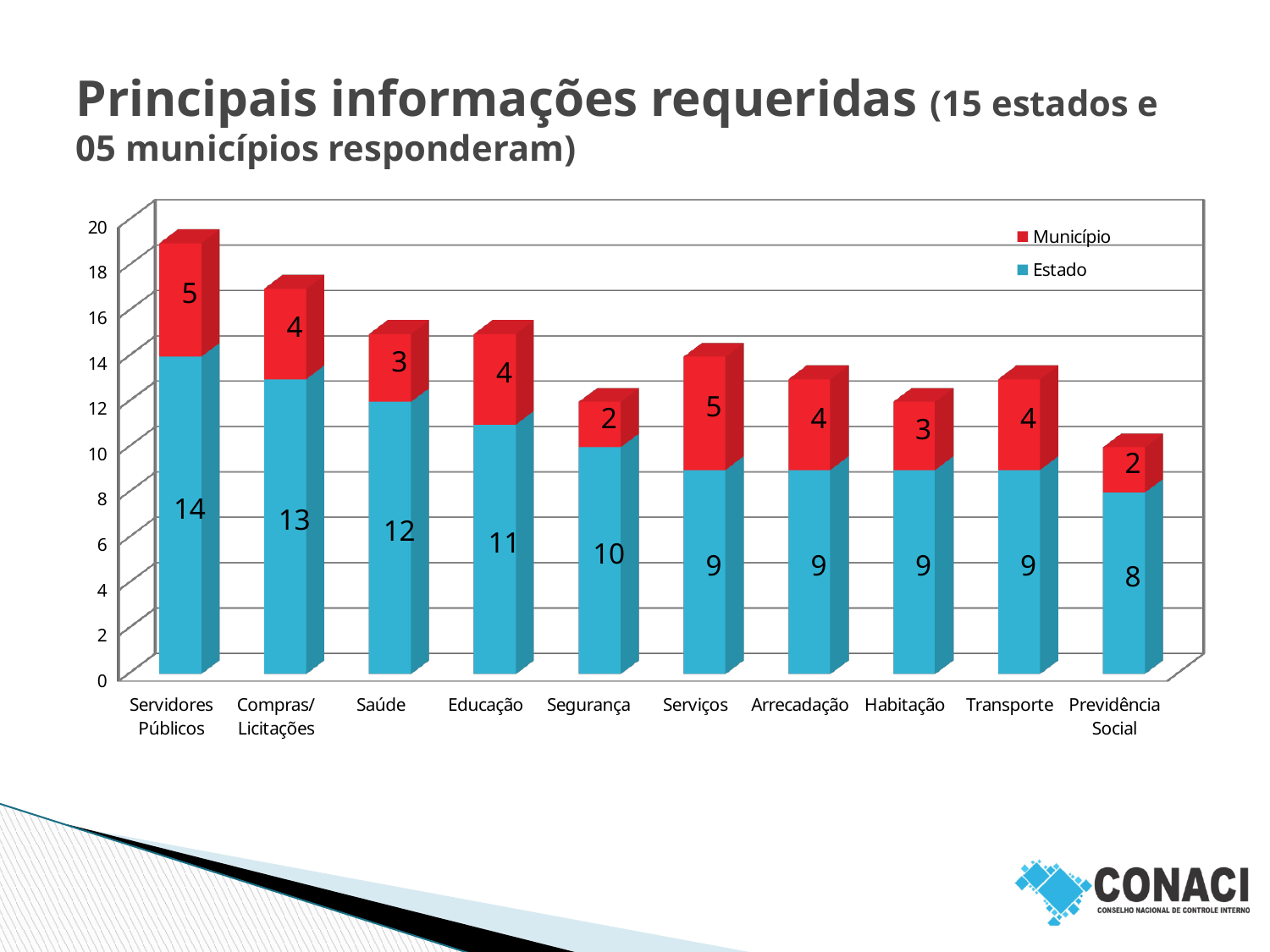
Which is larger, the Município value for Saúde or the Município value for Educação? Educação What is the Estado value for Servidores Públicos? 14 What is the Município value for Serviços? 5 What is the Estado value for Previdência Social? 8 What is the difference between the Estado values for Servidores Públicos and Saúde? 2 What is the total of the stacked bar for Servidores Públicos? 19 Which category has the highest Estado value? Servidores Públicos Which category has the lowest Estado value? Previdência Social How many series does the legend list? 2 What kind of chart is shown on the slide? Stacked bar chart How many categories are shown on the x axis? 10 What is the total of the stacked bar for Previdência Social? 10